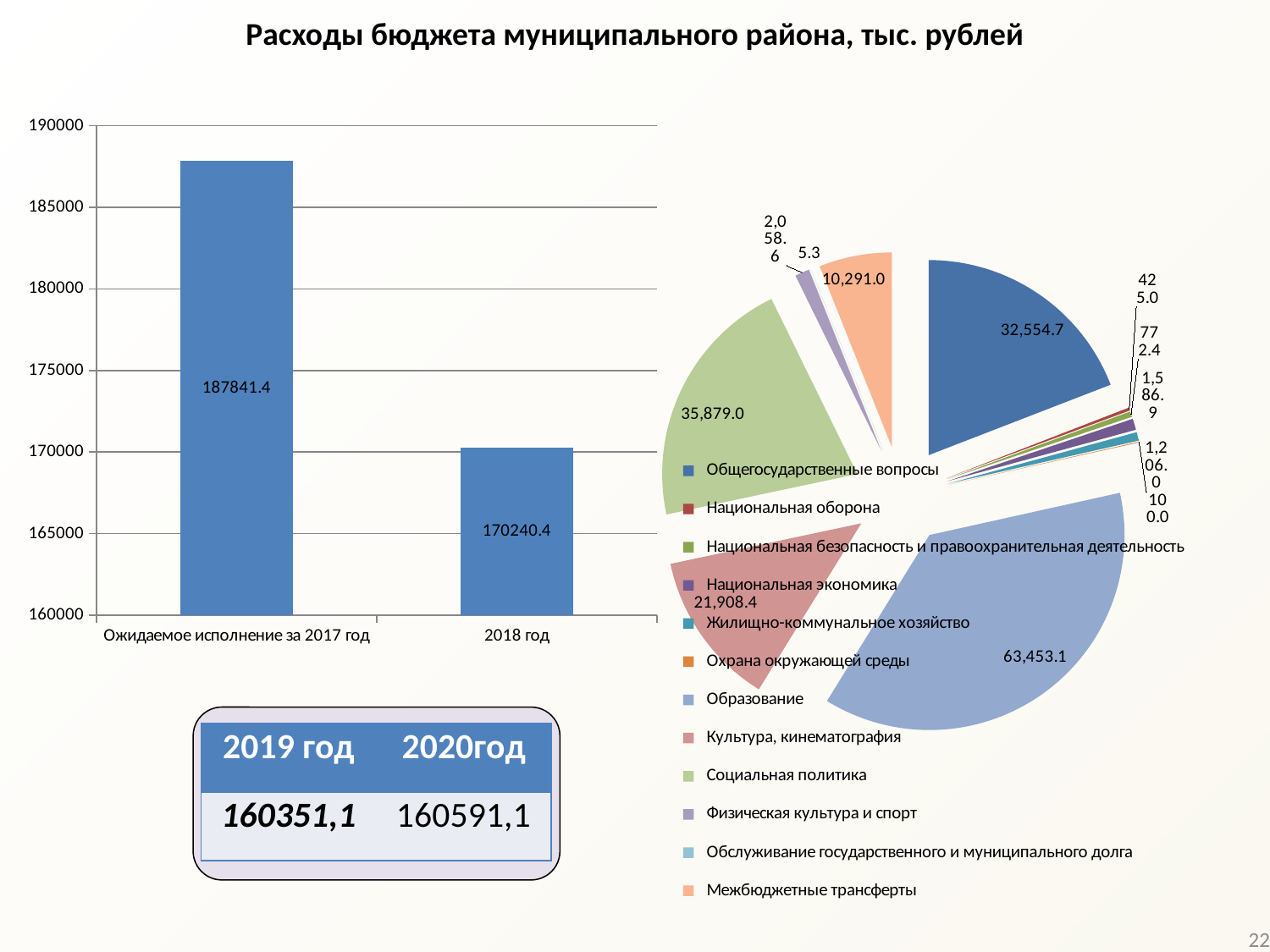
On the pie chart on the right, which category has the largest slice? Образование How many entries does the legend of the pie chart on the right list? 12 On the bar chart on the left, what is the difference between the 2017 expected value and the 2018 value? 17601.0 What type of chart is shown on the right side of the slide? pie chart On the bar chart on the left, how many bars are plotted? 2 On the pie chart on the right, what is the value for 'Образование'? 63,453.1 On the bar chart on the left, which category has the higher value? Ожидаемое исполнение за 2017 год On the bar chart on the left, what is the value for 'Ожидаемое исполнение за 2017 год'? 187841.4 What type of chart is shown on the left side of the slide? bar chart On the bar chart on the left, do the values rise or fall from 2017 to 2018? fall On the bar chart on the left, what is the value for '2018 год'? 170240.4 On the pie chart on the right, what is the value for 'Социальная политика'? 35,879.0